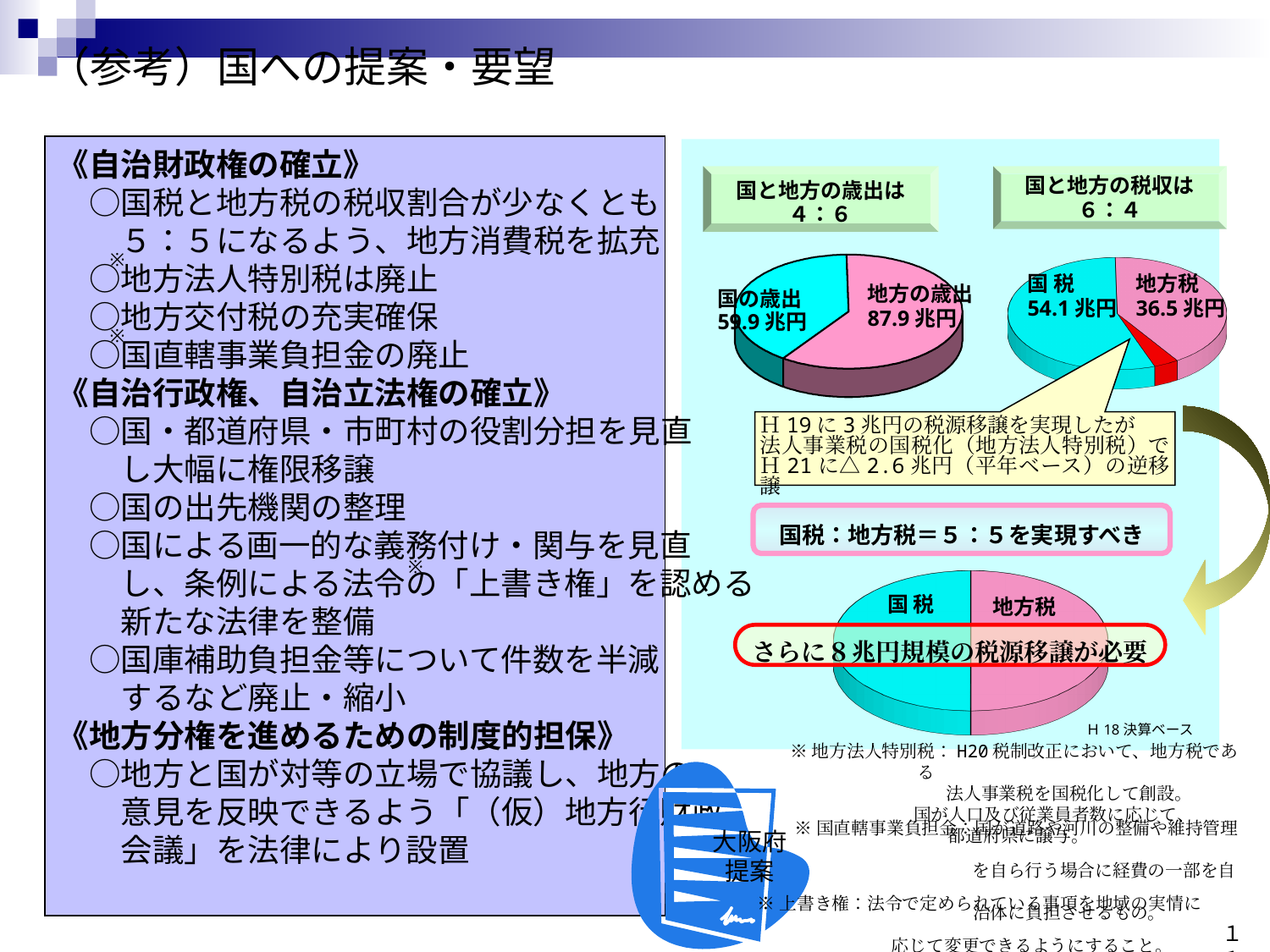
How many slices does the right pie chart (国と地方の税収は6：4) have? 3 What is the title shown above the left pie chart? 国と地方の歳出は4：6 In the left pie chart (国と地方の歳出は4：6), what is the difference between 地方の歳出 and 国の歳出? 28.0兆円 In the left pie chart (国と地方の歳出は4：6), which slice is larger, 国の歳出 or 地方の歳出? 地方の歳出 What kind of chart is used to show 国と地方の歳出 on the slide? Pie chart In the left pie chart (国と地方の歳出は4：6), what is the value for 地方の歳出? 87.9兆円 In the right pie chart (国と地方の税収は6：4), what is the difference between 国税 and 地方税? 17.6兆円 In the bottom pie chart, what are the two slices labelled? 国税 and 地方税 In the right pie chart (国と地方の税収は6：4), what is the value for 地方税? 36.5兆円 In the right pie chart (国と地方の税収は6：4), what is the value for 国税? 54.1兆円 In the left pie chart (国と地方の歳出は4：6), what is the value for 国の歳出? 59.9兆円 In the right pie chart (国と地方の税収は6：4), which slice is larger, 国税 or 地方税? 国税